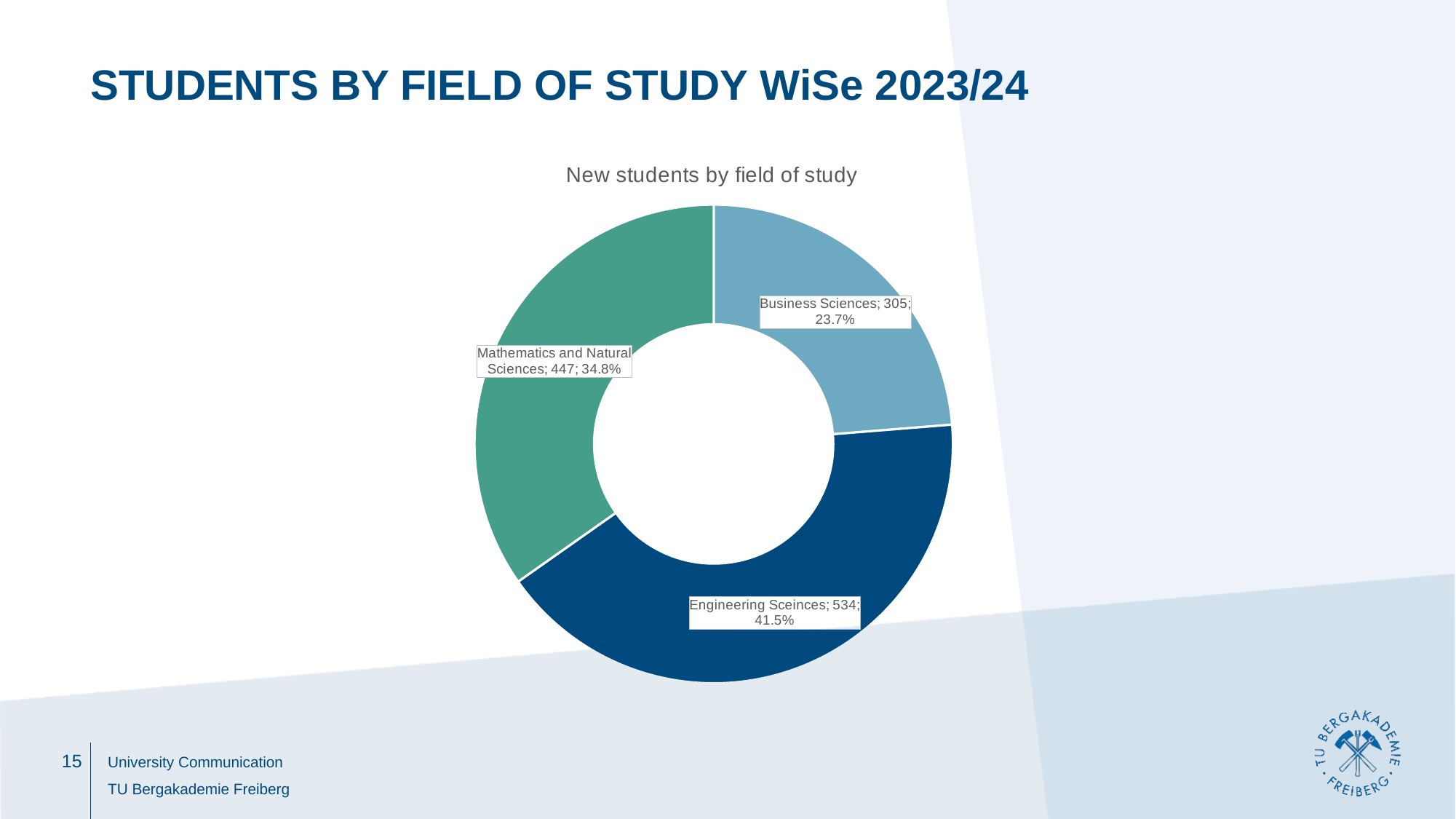
Which field of study has the most new students? Engineering Sceinces How many new students are in Business Sciences? 305 What share of new students is in Engineering Sciences? 41.5% How many more new students are in Mathematics and Natural Sciences than in Business Sciences? 142 What share of new students is in Business Sciences? 23.7% How many new students are in Mathematics and Natural Sciences? 447 How many fields of study are shown in the chart? 3 Which field of study has the fewest new students? Business Sciences How many more new students are in Engineering Sciences than in Business Sciences? 229 What type of chart is shown on the slide? Doughnut (pie) chart Which has more new students, Mathematics and Natural Sciences or Business Sciences? Mathematics and Natural Sciences How many new students are in Engineering Sciences? 534